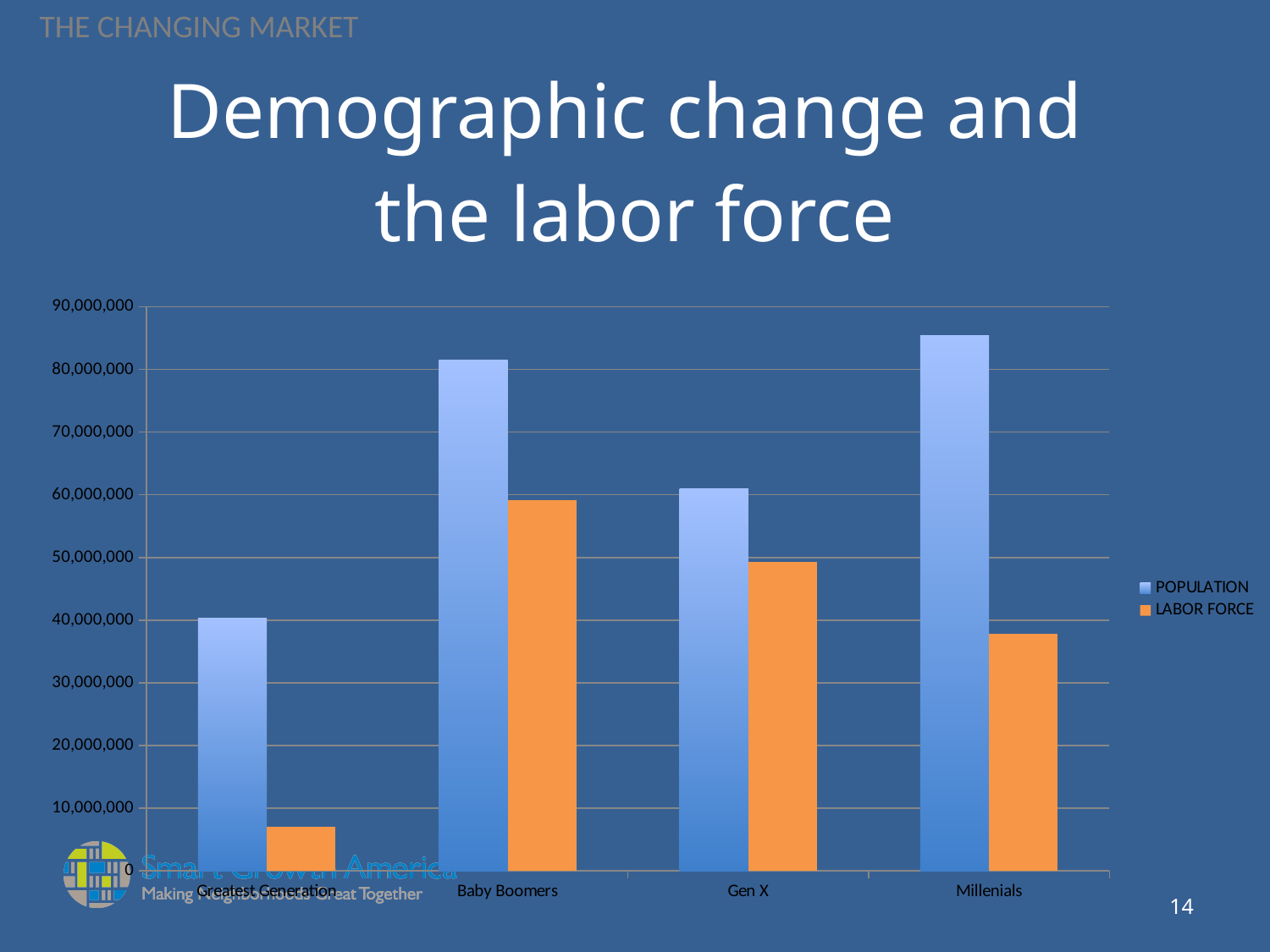
Which is larger, the POPULATION for Baby Boomers or the POPULATION for Gen X? Baby Boomers How many series does the legend list? 2 Which generation has the highest LABOR FORCE bar? Baby Boomers Which generation has the lowest POPULATION bar? Greatest Generation What is the title of the slide containing the chart? Demographic change and the labor force Is the LABOR FORCE value for Greatest Generation greater or less than 10,000,000? less Which generation has the highest POPULATION bar? Millenials Which is larger, the LABOR FORCE for Gen X or the LABOR FORCE for Millenials? Gen X How many generation categories are shown on the x axis? 4 Which generation has the lowest LABOR FORCE bar? Greatest Generation What kind of chart is shown on the slide? bar chart Is the POPULATION value for Greatest Generation greater or less than 50,000,000? less